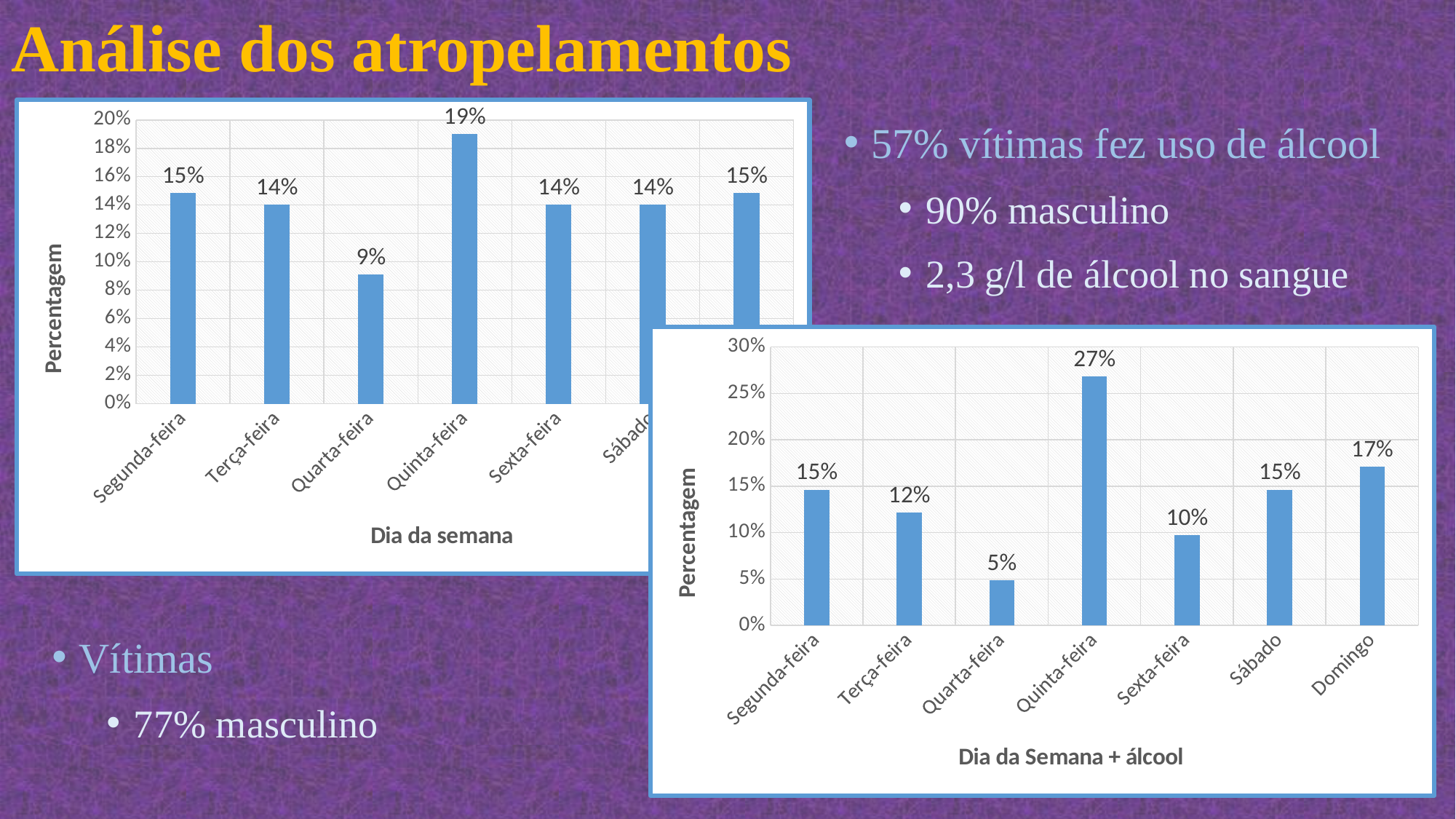
How many categories are shown in the right chart ('Dia da Semana + álcool')? 7 In the left chart (x-axis 'Dia da semana'), which day has the highest value? Quinta-feira In the right chart ('Dia da Semana + álcool'), what is the value for Quinta-feira? 27% In the left chart (x-axis 'Dia da semana'), what is the difference between the values for Quinta-feira and Quarta-feira? 10% What type of chart is the right chart ('Dia da Semana + álcool')? Bar chart In the right chart ('Dia da Semana + álcool'), what is the value for Domingo? 17% In the right chart ('Dia da Semana + álcool'), which is larger, the value for Terça-feira or the value for Sexta-feira? Terça-feira In the left chart (x-axis 'Dia da semana'), what is the value for Quarta-feira? 9% In the right chart ('Dia da Semana + álcool'), what is the difference between the values for Quinta-feira and Sexta-feira? 17% In the right chart ('Dia da Semana + álcool'), which day has the lowest value? Quarta-feira In the left chart (x-axis 'Dia da semana'), which day has the lowest value? Quarta-feira In the left chart (x-axis 'Dia da semana'), what is the value for Quinta-feira? 19%